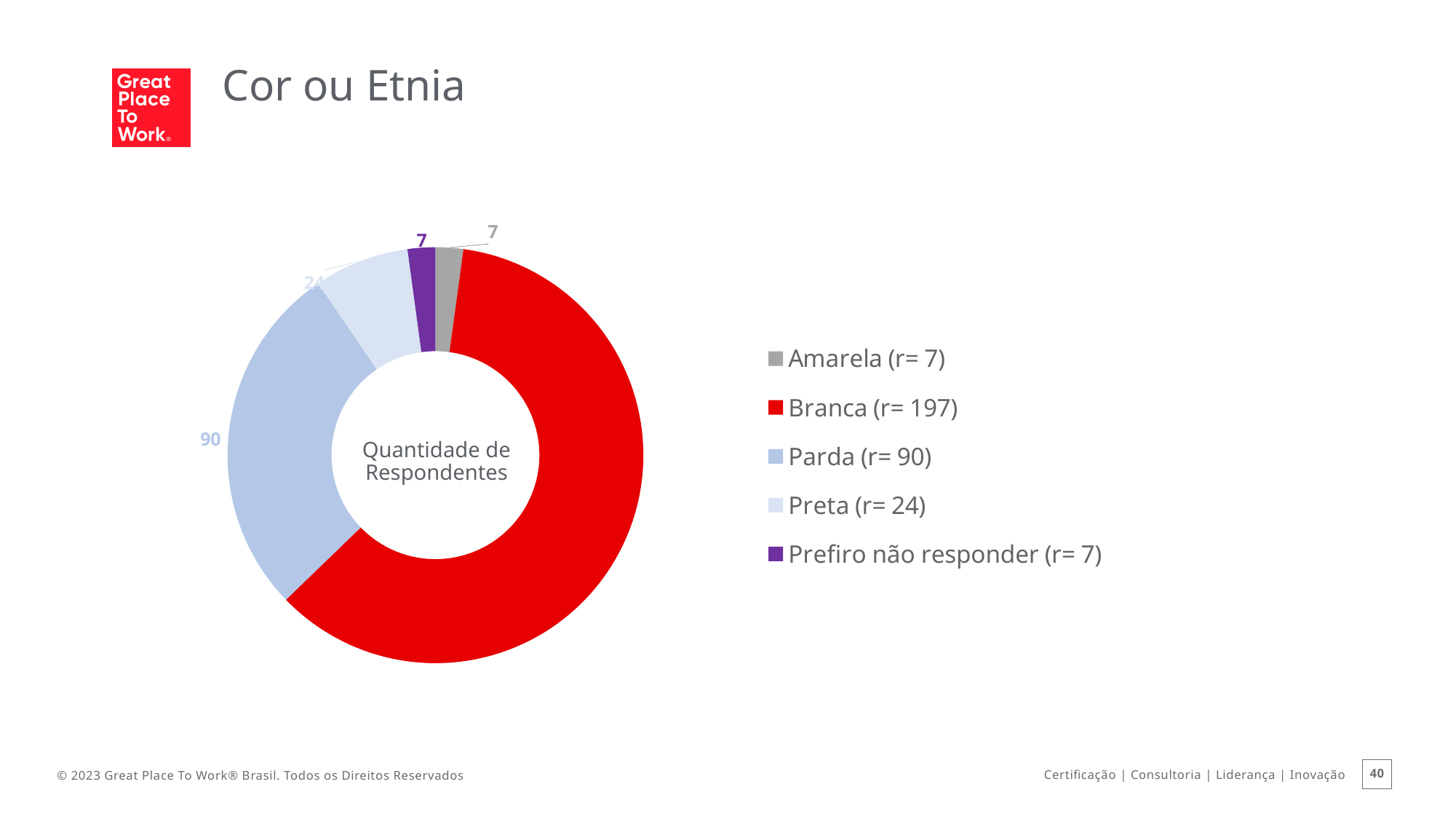
What is the total number of respondents across all categories? 325 Which has more respondents, Preta or Amarela? Preta How many categories does the legend list? 5 Which category has the largest number of respondents? Branca What is the difference in respondents between Parda and Preta? 66 How many respondents chose Prefiro não responder? 7 What kind of chart is shown on the slide? Donut (pie) chart What is the title of the slide containing the chart? Cor ou Etnia What is the difference in respondents between Branca and Parda? 107 How many respondents are in the Parda category? 90 How many respondents are in the Preta category? 24 How many respondents are in the Branca category? 197